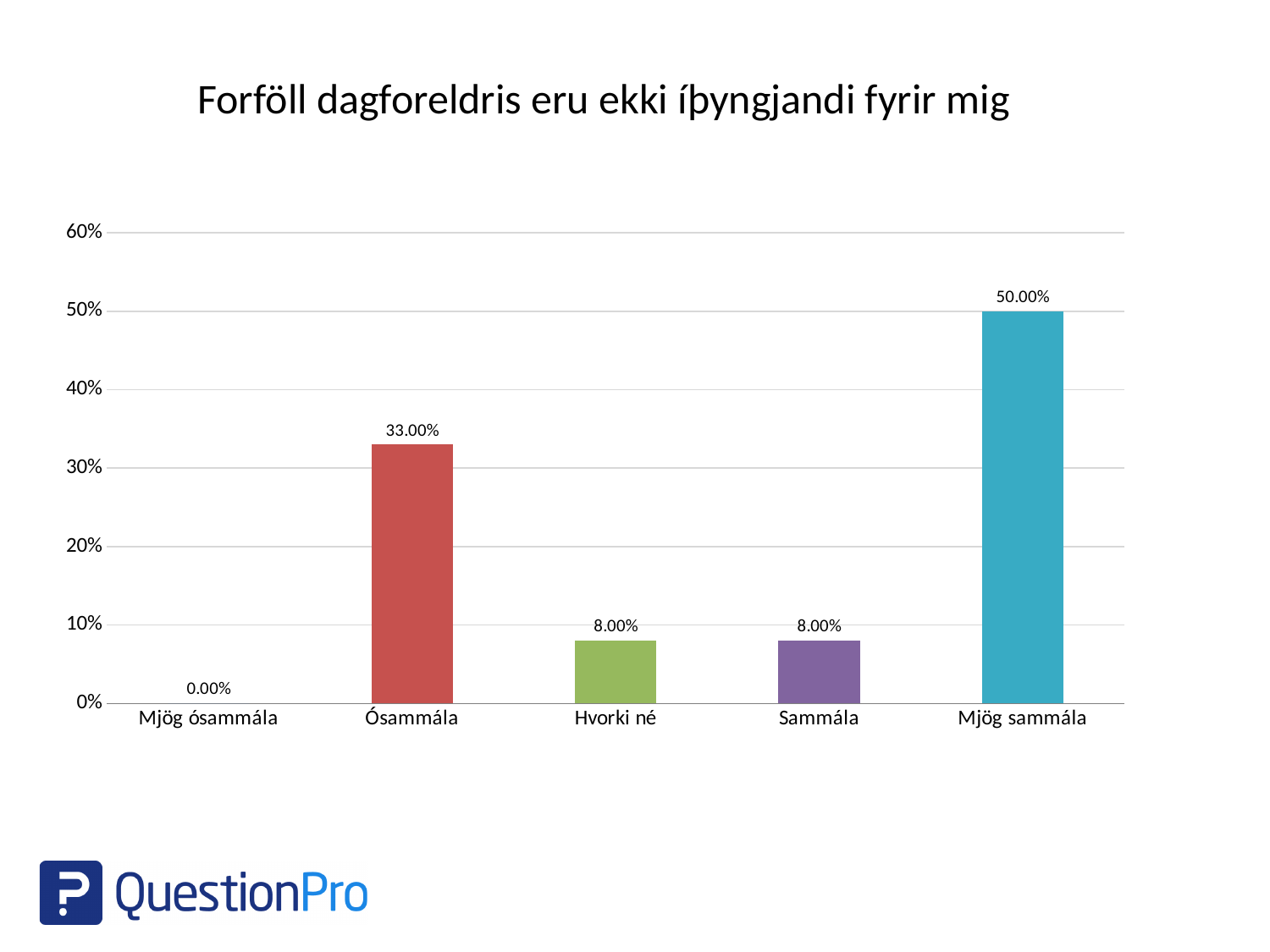
What is the value for Mjög ósammála? 0.00% Which category has the lowest value? Mjög ósammála What is the value for Ósammála? 33.00% Which category has the highest value? Mjög sammála What is the value for Mjög sammála? 50.00% Which is larger, the value for Ósammála or the value for Sammála? Ósammála What kind of chart is shown on the slide? bar chart What is the title of the chart? Forföll dagforeldris eru ekki íþyngjandi fyrir mig What is the value for Hvorki né? 8.00% What is the difference between the values for Mjög sammála and Ósammála? 17.00% How many categories are shown on the x axis? 5 Is the value for Ósammála greater or less than 30%? greater